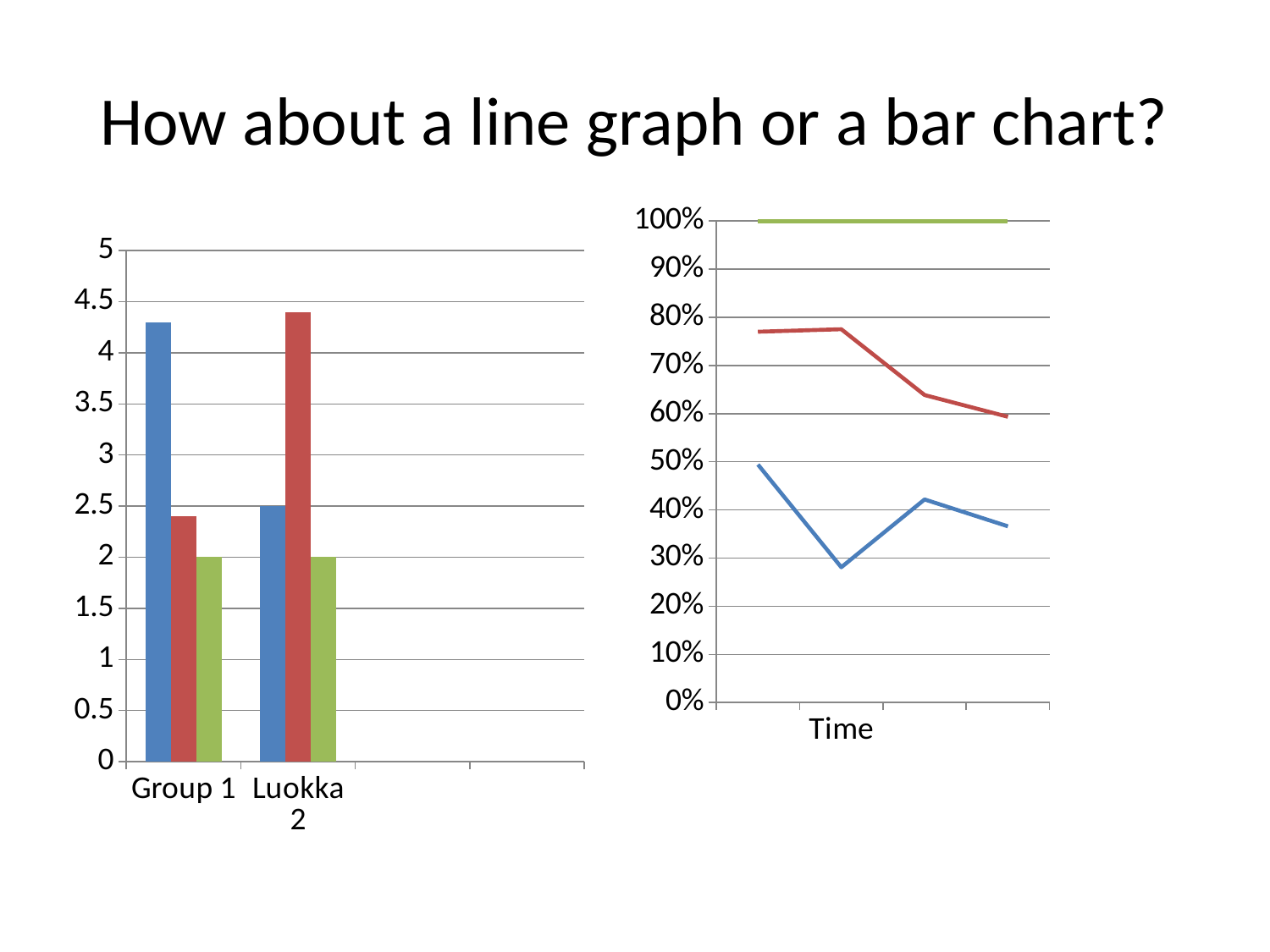
In the bar chart on the left, how many categories are shown on the x axis? 2 In the line chart on the right, what is the label on the x axis? Time In the bar chart on the left, which bar is taller for Group 1, the blue bar or the red bar? the blue bar In the line chart on the right, does the red line rise or fall over time? fall In the bar chart on the left, what is the value of the blue bar for Luokka 2? 2.5 What kind of chart is the chart on the right of the slide? line chart In the bar chart on the left, is the value of the blue bar for Group 1 greater or less than 4? greater What kind of chart is the chart on the left of the slide? bar chart In the line chart on the right, at what value does the green line stay throughout? 100% In the bar chart on the left, is the value of the red bar for Luokka 2 greater or less than 4? greater In the bar chart on the left, what is the value of the green bar for Group 1? 2 In the line chart on the right, how many lines are plotted? 3